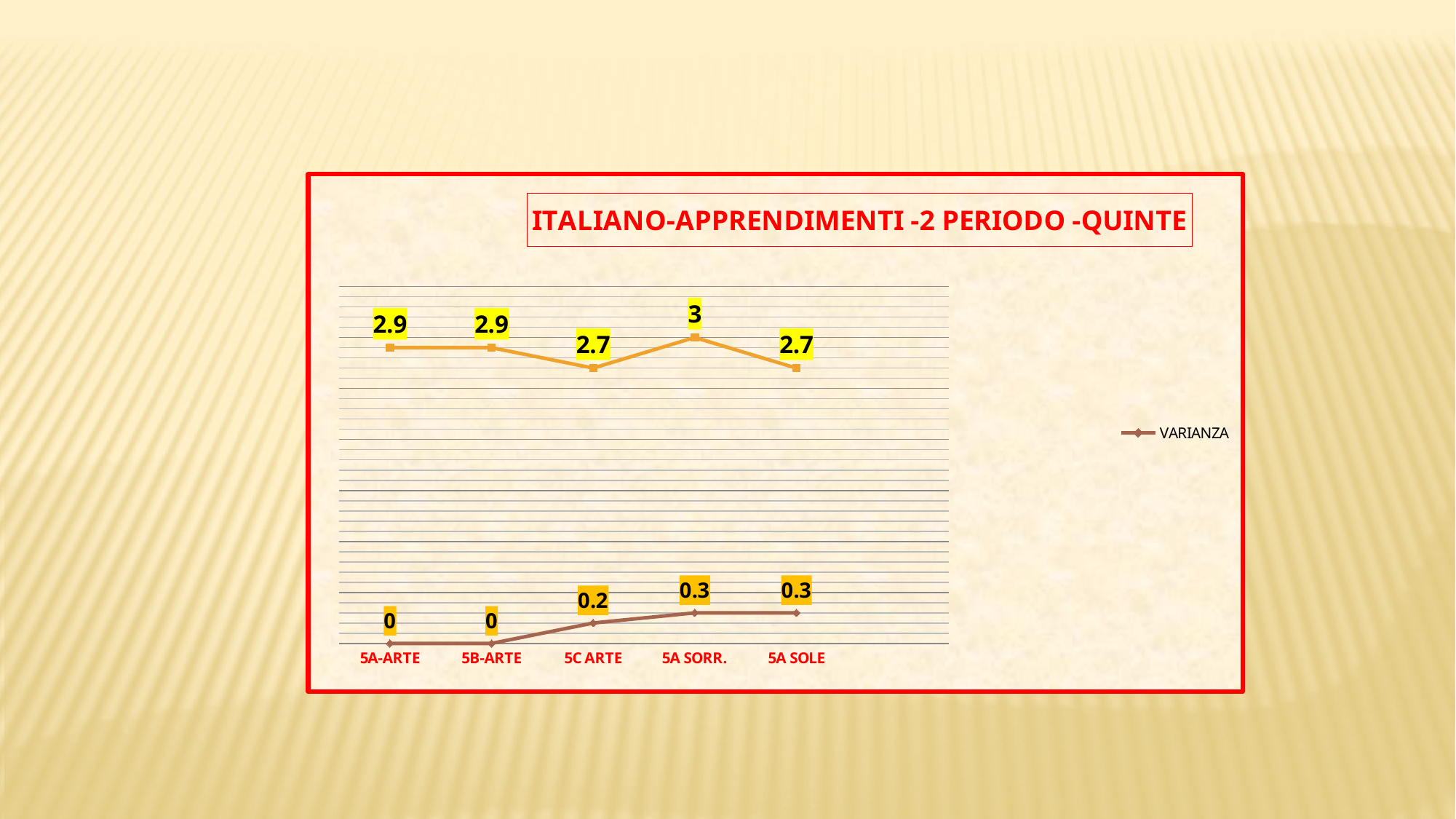
How many series does the legend list? 1 What is the difference between the upper orange line values for 5A SORR. and 5A SOLE? 0.3 Which category has the highest value on the upper orange line? 5A SORR. What is the VARIANZA value for 5A SOLE? 0.3 How many categories are shown on the x axis? 5 What is the VARIANZA value for 5C ARTE? 0.2 What is the value of the upper orange line for 5C ARTE? 2.7 Which categories have the lowest VARIANZA value? 5A-ARTE and 5B-ARTE Which is larger, the VARIANZA value for 5C ARTE or for 5A SORR.? 5A SORR. What kind of chart is shown on the slide? Line chart What is the value of the upper orange line for 5A SORR.? 3 What is the title of the chart? ITALIANO-APPRENDIMENTI -2 PERIODO -QUINTE